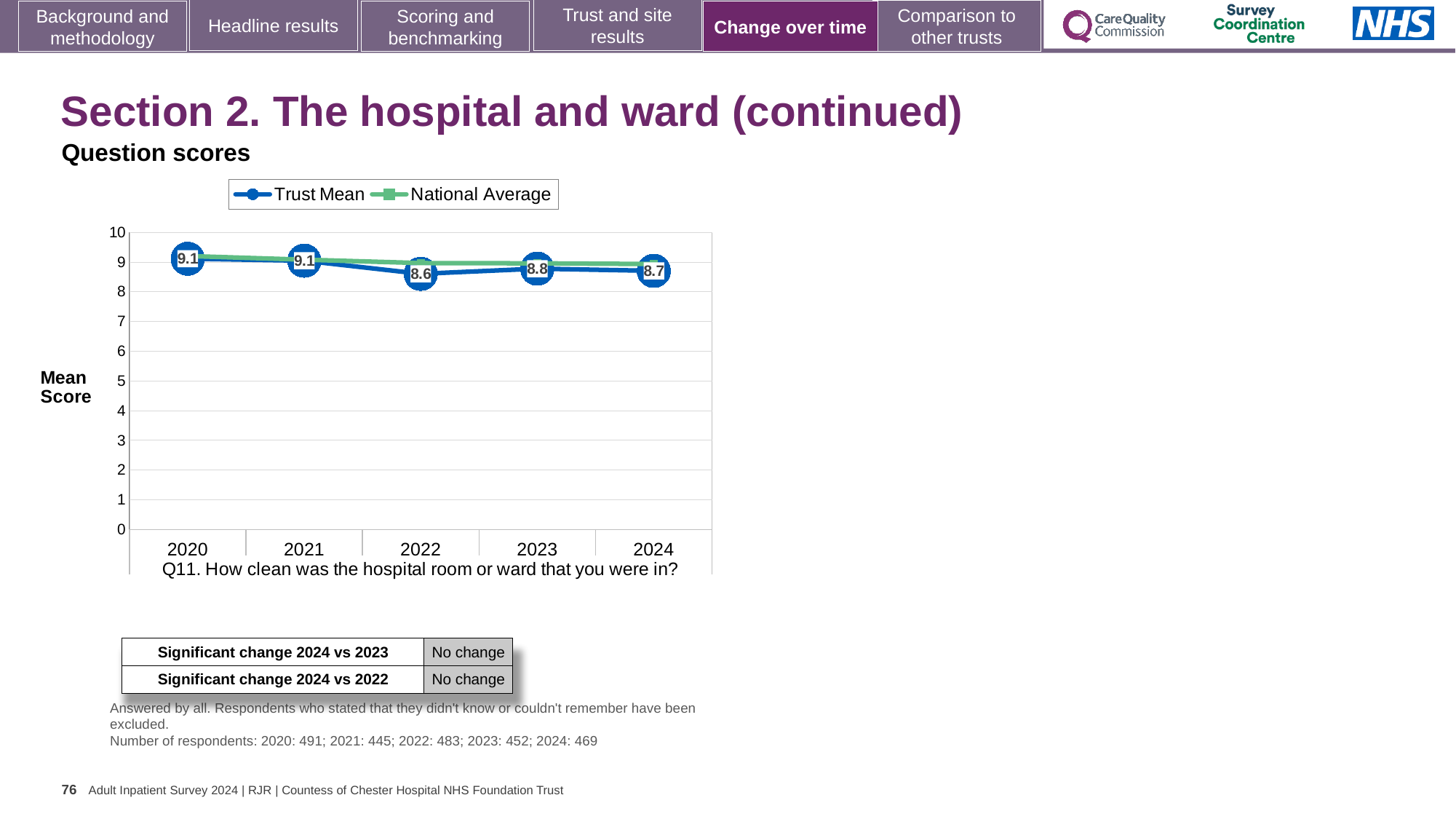
Which year has the higher Trust Mean, 2022 or 2023? 2023 What is the Trust Mean value for 2024? 8.7 What kind of chart is shown? line chart In which year is the Trust Mean lowest? 2022 Is the National Average value for 2024 greater or less than 8? greater What is the Trust Mean value for 2022? 8.6 Which survey question does the chart show scores for? Q11. How clean was the hospital room or ward that you were in? How many years are plotted on the x axis? 5 What is the Trust Mean value for 2020? 9.1 What is the difference between the Trust Mean in 2020 and in 2022? 0.5 How many series does the legend list? 2 Does the Trust Mean rise or fall overall from 2020 to 2024? fall